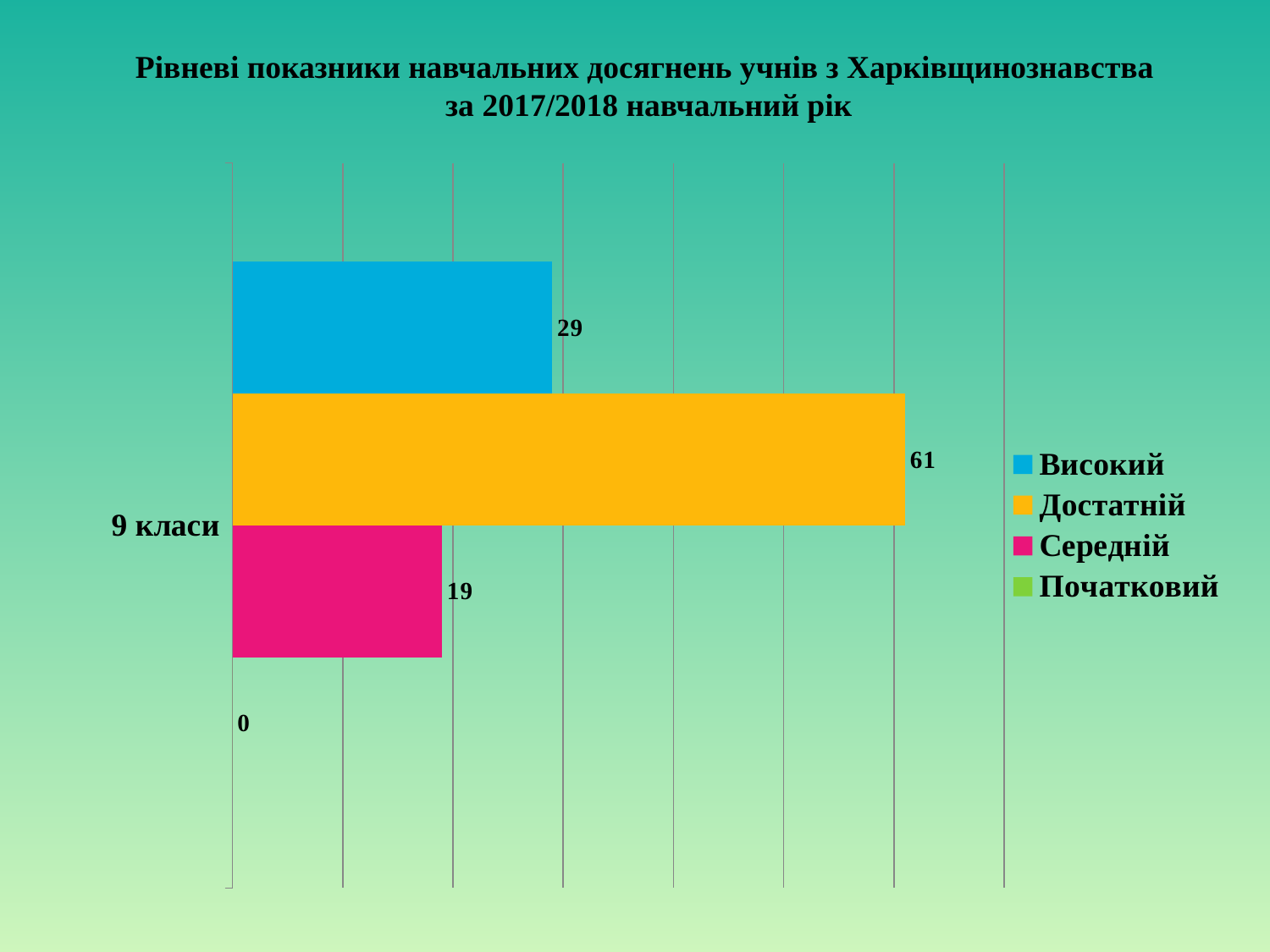
What is the difference between the Високий and Середній values for 9 класи? 10 What kind of chart is shown on the slide? Bar chart Which is larger for 9 класи, Високий or Середній? Високий What colour is the bar for Достатній? Yellow What is the difference between the Достатній and Високий values for 9 класи? 32 What is the value for Початковий for 9 класи? 0 Which series has the lowest value for 9 класи? Початковий Which series has the highest value for 9 класи? Достатній What is the value for Достатній for 9 класи? 61 How many series does the legend list? 4 What is the value for Високий for 9 класи? 29 What is the value for Середній for 9 класи? 19